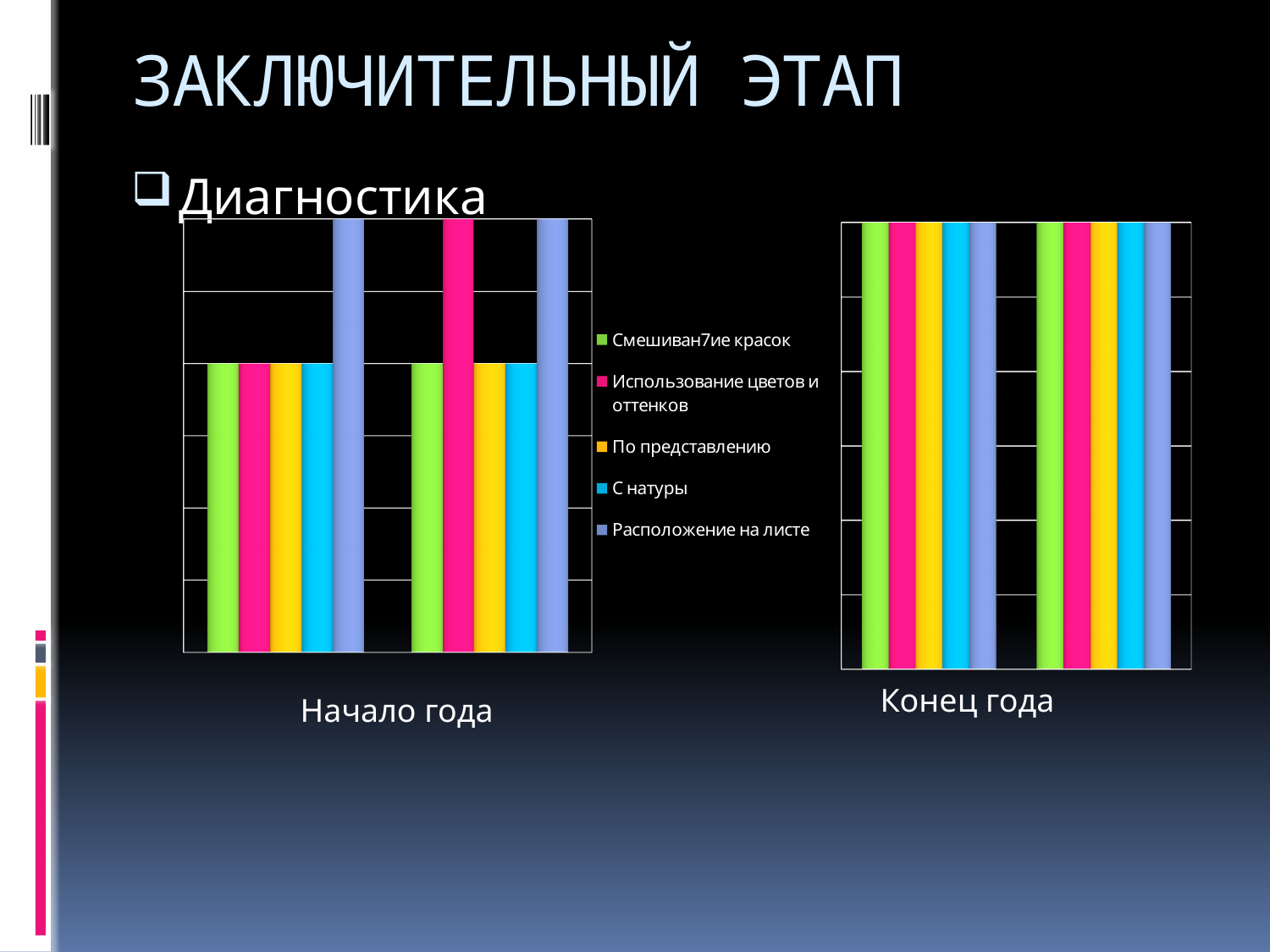
What kind of chart is the chart titled "Начало года"? bar chart In the chart titled "Начало года", how many groups of bars are plotted? 2 In the chart titled "Начало года", in the first (left) group, which is larger: the bar for Смешиван7ие красок or the bar for Расположение на листе? Расположение на листе In the chart titled "Конец года", are all the bars the same height? Yes In the chart titled "Начало года", which series has the tallest bar in the first (left) group? Расположение на листе How many series does the legend list for the charts on the slide? 5 In the chart titled "Начало года", in the second (right) group, which is larger: the bar for Использование цветов и оттенков or the bar for По представлению? Использование цветов и оттенков What is the title shown under the right-hand chart? Конец года What kind of chart is the chart titled "Конец года"? bar chart In the chart titled "Конец года", how many groups of bars are plotted? 2 Which series is shown in green in the legend? Смешиван7ие красок